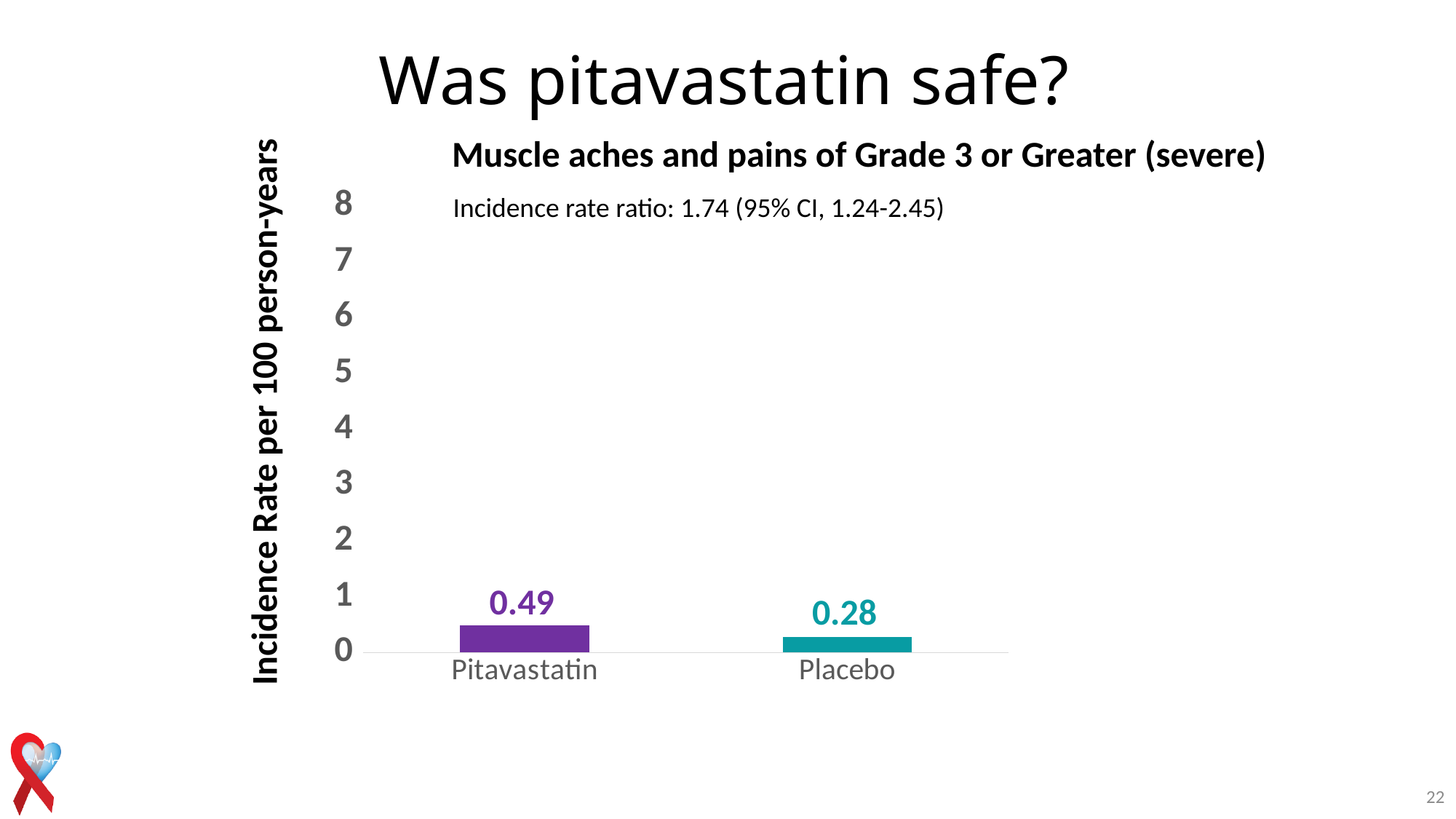
Which group has the higher incidence rate of severe muscle aches and pains? Pitavastatin What is the incidence rate per 100 person-years for Pitavastatin? 0.49 What is the label of the y axis? Incidence Rate per 100 person-years How many categories are shown on the x axis of the chart? 2 What is the title of the chart? Muscle aches and pains of Grade 3 or Greater (severe) What kind of chart is shown on the slide? bar chart Is the value for Pitavastatin greater or less than 1? less Is the incidence rate for Pitavastatin larger or smaller than that for Placebo? larger What is the incidence rate per 100 person-years for Placebo? 0.28 Which group has the lower incidence rate of severe muscle aches and pains? Placebo What is the highest value shown on the y axis? 8 What is the difference between the incidence rates for Pitavastatin and Placebo? 0.21